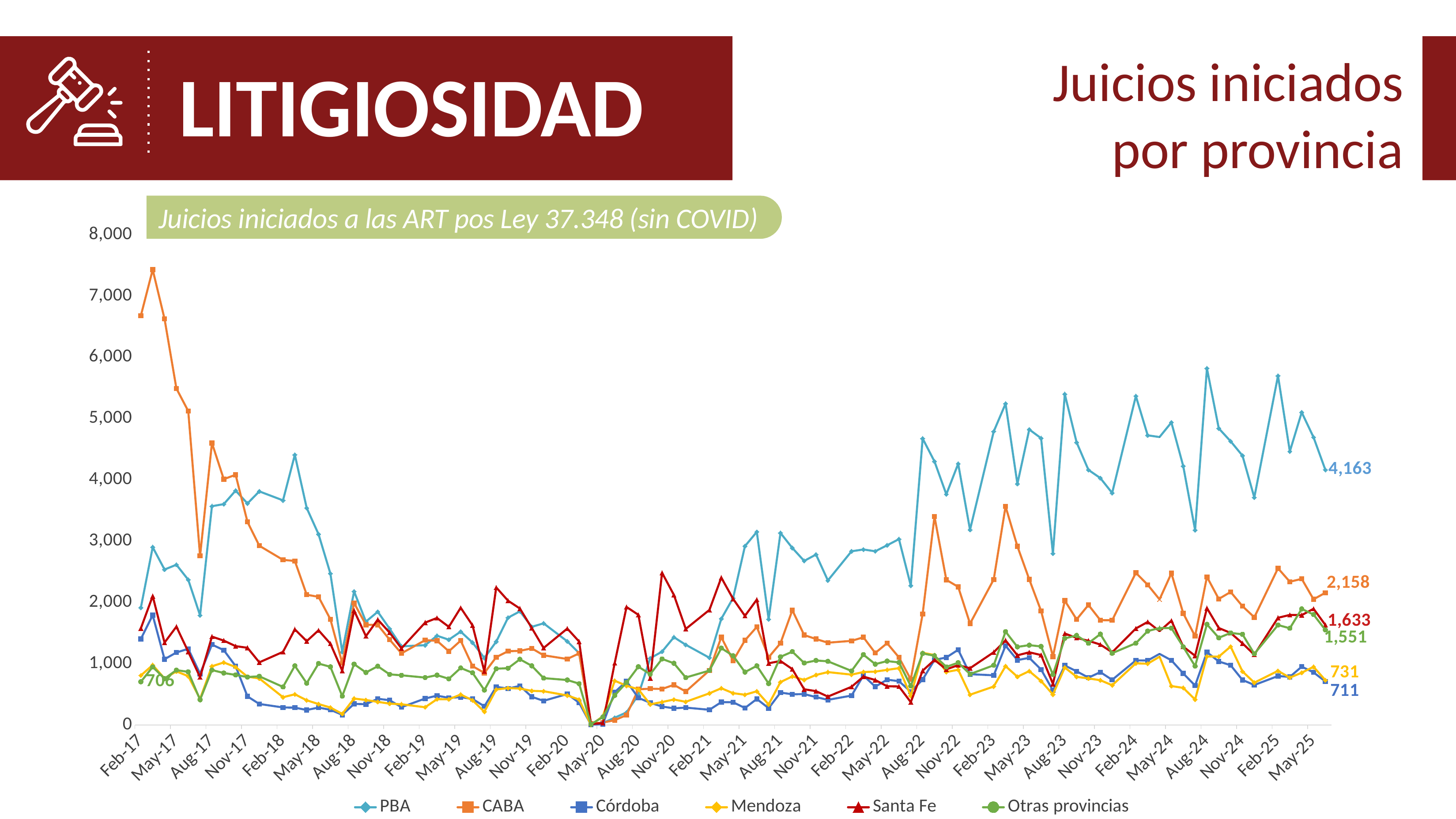
Is the value for CABA at Feb-17 greater or less than 6,000? greater What is the labelled value for Otras provincias at the start of the series (Feb-17)? 706 How many series does the legend list? 6 Which series has the highest labelled value at the end of the series? PBA What kind of chart is shown on the slide? Line chart What is the labelled value for Otras provincias at the end of the series? 1,551 What is the difference between the final labelled values of PBA and CABA? 2,005 Which series has the lowest labelled value at the end of the series? Córdoba What is the labelled value for Santa Fe at the end of the series? 1,633 At the end of the series, which is larger: Mendoza or Córdoba? Mendoza What is the labelled value for CABA at the end of the series? 2,158 What is the labelled value for PBA at the end of the series (May-25)? 4,163